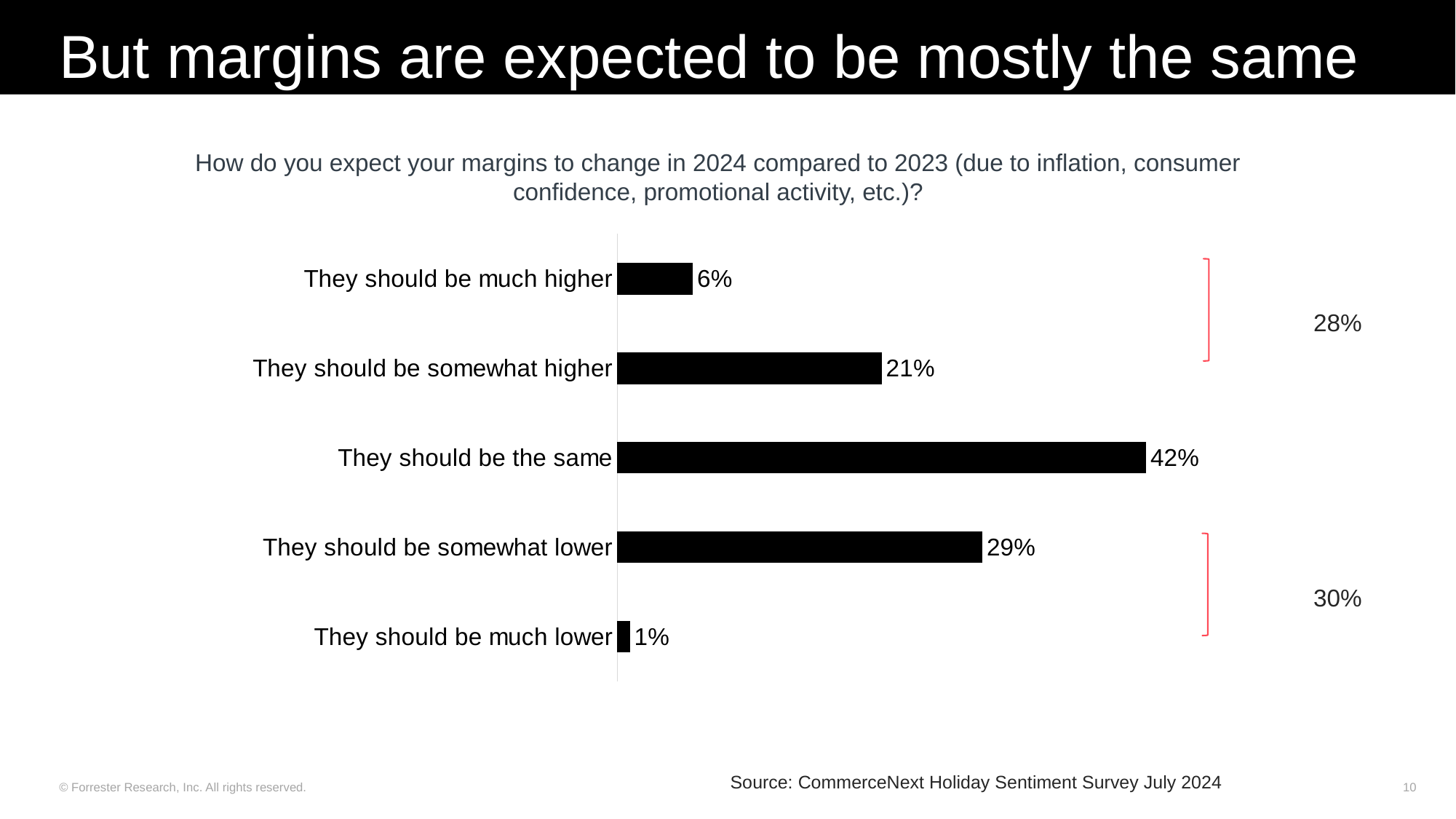
What type of chart is shown on the slide? Bar chart Which response category has the lowest percentage? They should be much lower How many response categories are shown in the chart? 5 What is the difference in percentage points between 'They should be the same' and 'They should be somewhat lower'? 13 What percentage of respondents said margins should be the same? 42% What is the difference in percentage points between 'They should be somewhat higher' and 'They should be much higher'? 15 Which response category has the highest percentage? They should be the same What combined percentage is shown by the bracket for the two 'lower' categories? 30% What percentage of respondents said margins should be much higher? 6% What percentage of respondents said margins should be somewhat lower? 29% Which is larger: the percentage for 'They should be somewhat higher' or 'They should be somewhat lower'? They should be somewhat lower What combined percentage is shown by the bracket for the two 'higher' categories? 28%